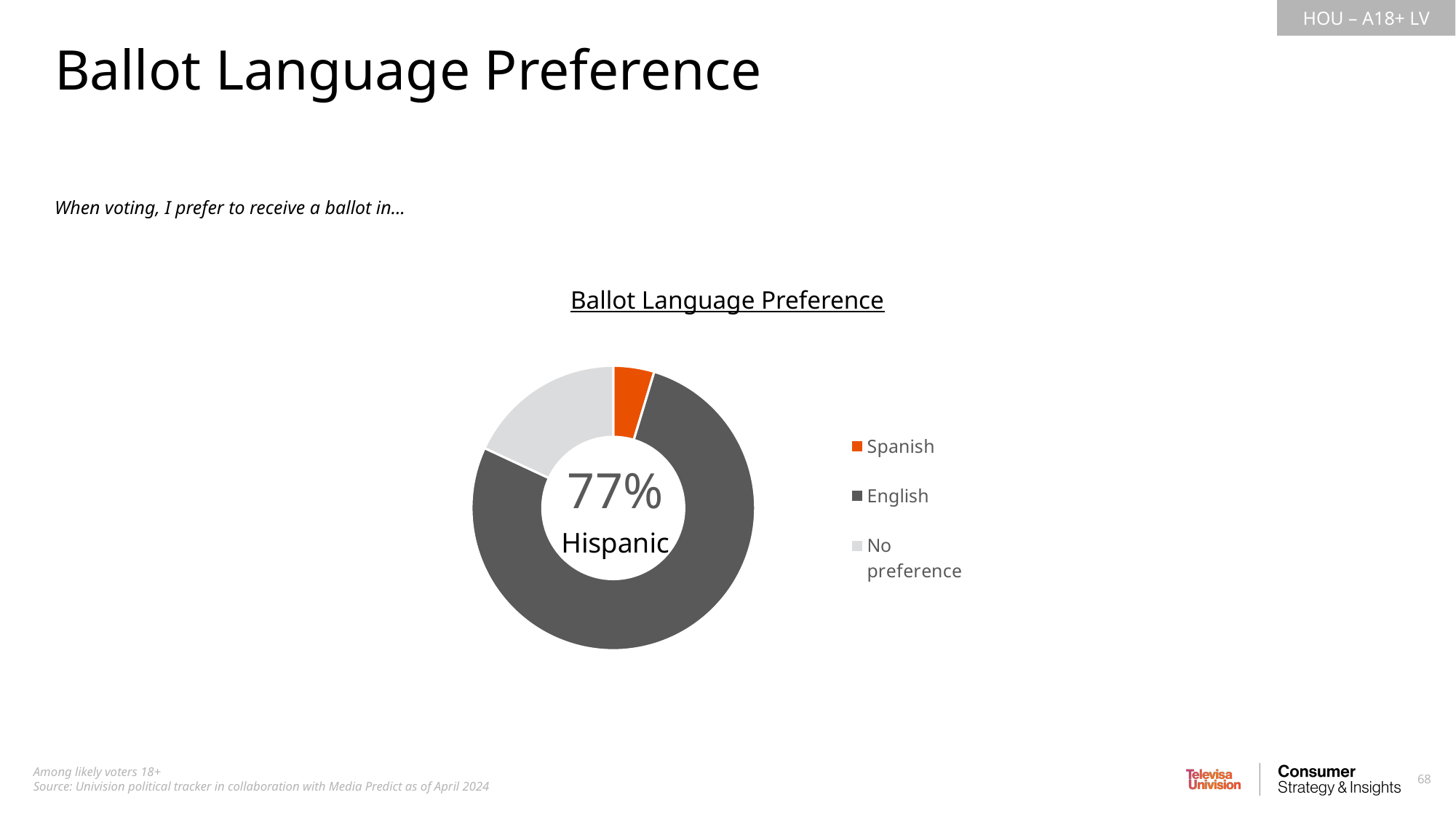
Which slice is smaller, Spanish or English? Spanish What percentage is printed in the centre of the donut chart? 77% How many categories does the Ballot Language Preference chart show? 3 Which slice is larger, No preference or Spanish? No preference How many entries does the legend of the Ballot Language Preference chart list? 3 Which category has the largest slice in the Ballot Language Preference chart? English What kind of chart is shown on the slide? pie chart (donut) What colour represents Spanish in the Ballot Language Preference chart? Orange Which slice is larger, English or No preference? English Which category has the smallest slice in the Ballot Language Preference chart? Spanish